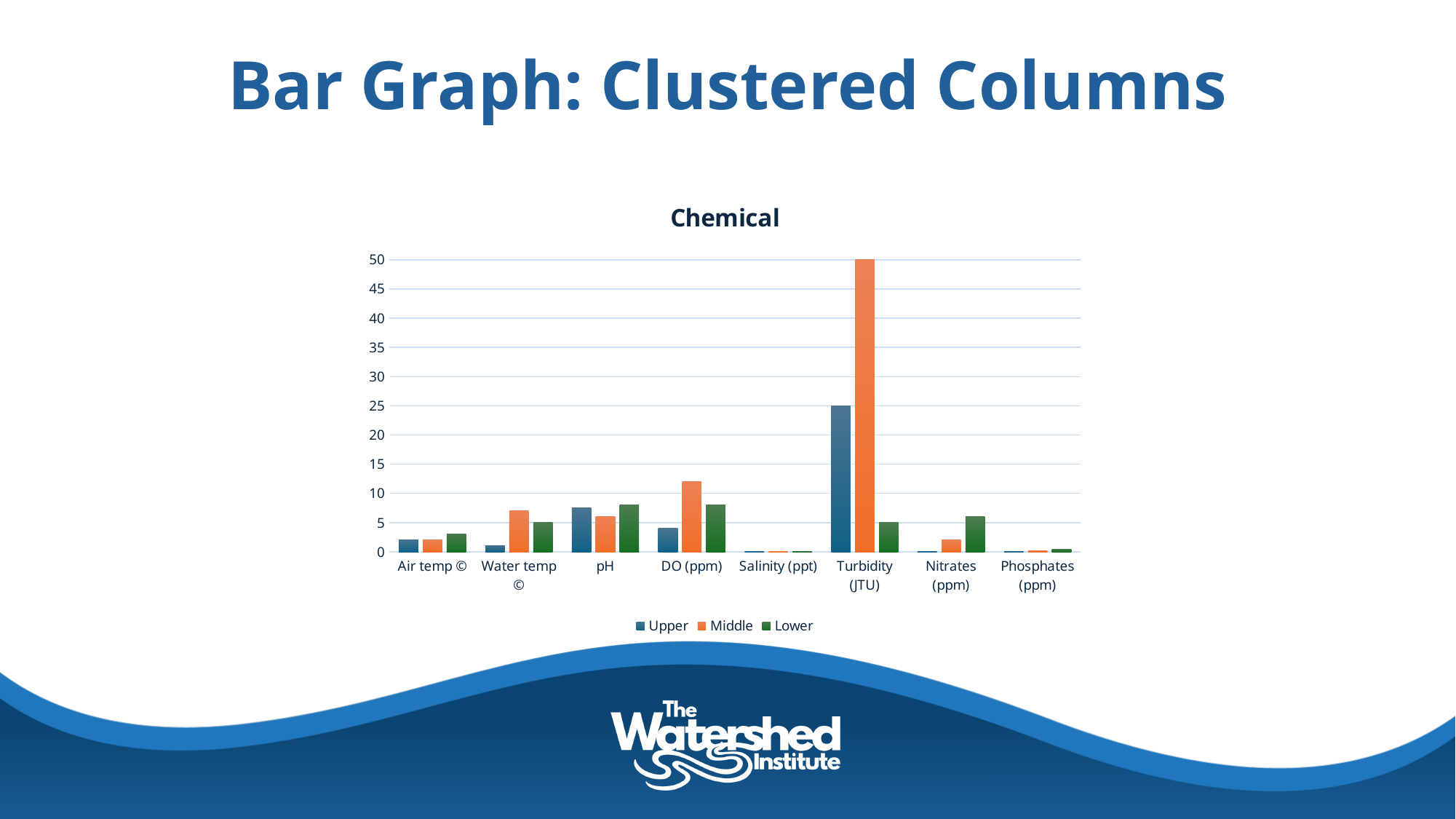
Which category has the highest Middle value? Turbidity (JTU) How many categories are shown on the x axis? 8 For DO (ppm), which is larger, the Upper value or the Middle value? Middle What is the difference between the Middle and Upper values for Turbidity (JTU)? 25 Which series is shown in orange in the legend? Middle Is the Middle value for DO (ppm) greater or less than 10? greater What kind of chart is shown on the slide? bar chart What is the Middle value for Turbidity (JTU)? 50 How many series does the legend list? 3 Is the Lower value for Nitrates (ppm) greater or less than 10? less What is the Upper value for Turbidity (JTU)? 25 What is the title of the chart? Chemical